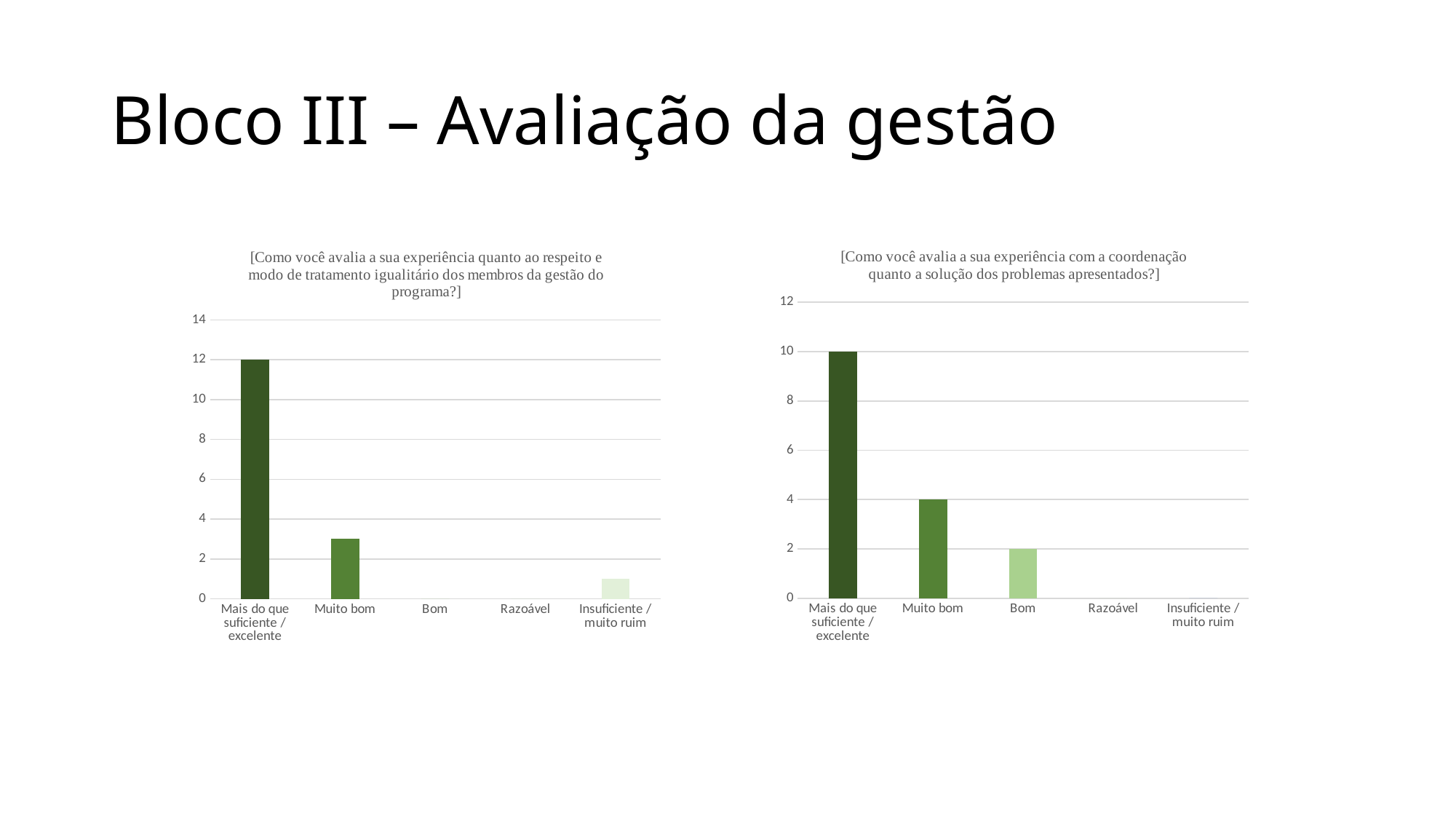
What kind of chart is the left chart (respeito e modo de tratamento igualitário)? bar chart In the left chart (respeito e modo de tratamento igualitário), is the value for 'Muito bom' greater or less than 2? greater In the right chart (coordenação quanto a solução dos problemas), what is the value for 'Mais do que suficiente / excelente'? 10 In the right chart (coordenação quanto a solução dos problemas), which is larger: 'Muito bom' or 'Bom'? Muito bom In the right chart (coordenação quanto a solução dos problemas), what is the value for 'Muito bom'? 4 In the right chart (coordenação quanto a solução dos problemas), what is the difference between 'Muito bom' and 'Bom'? 2 In the left chart (respeito e modo de tratamento igualitário), is the value for 'Insuficiente / muito ruim' greater or less than 2? less In the right chart (coordenação quanto a solução dos problemas), what is the value for 'Bom'? 2 How many categories are shown on the x axis of the right chart (coordenação quanto a solução dos problemas)? 5 In the left chart (respeito e modo de tratamento igualitário), what is the value for 'Mais do que suficiente / excelente'? 12 In the left chart (respeito e modo de tratamento igualitário), which category has the highest value? Mais do que suficiente / excelente In the right chart (coordenação quanto a solução dos problemas), what is the difference between 'Mais do que suficiente / excelente' and 'Muito bom'? 6